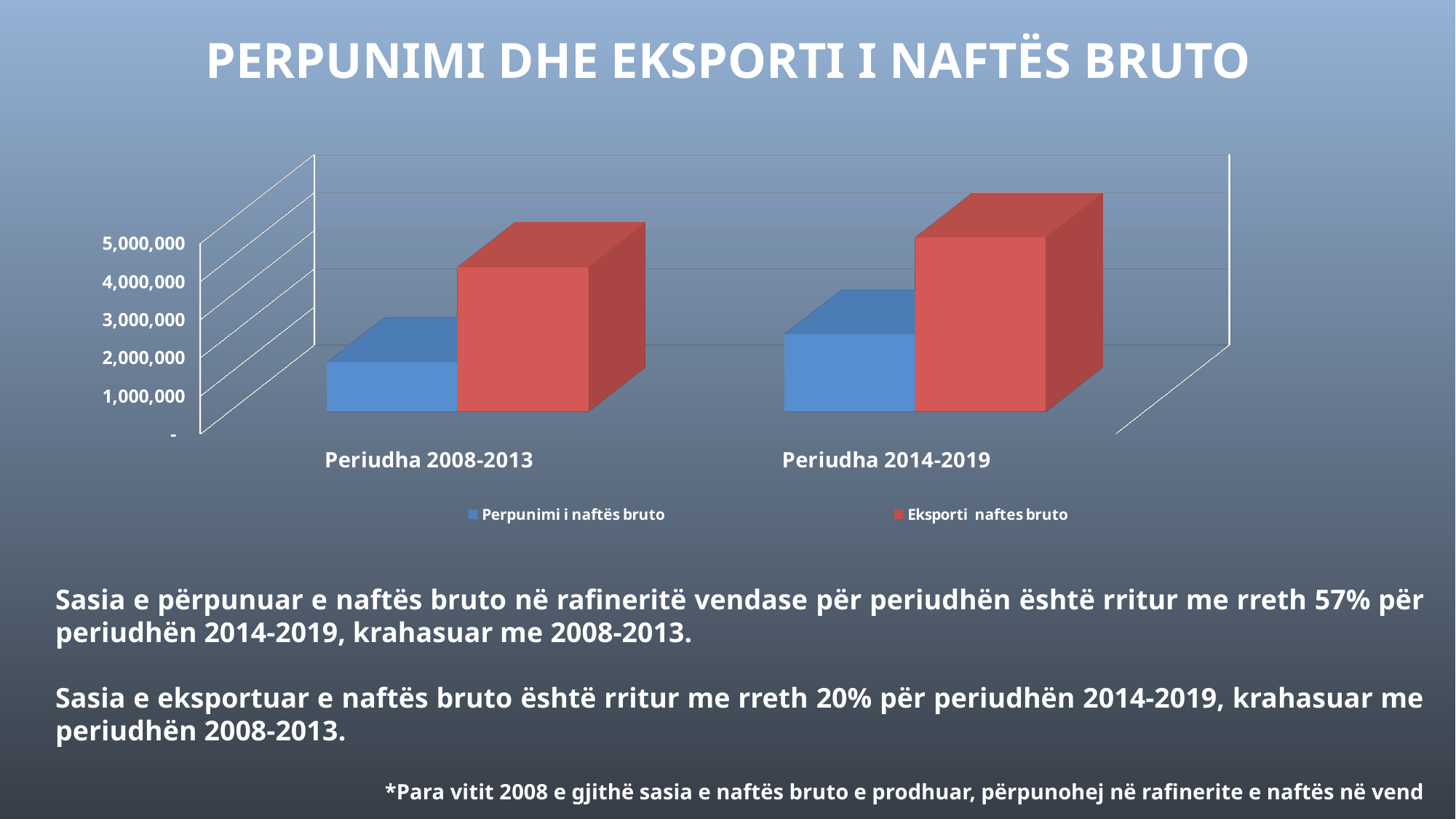
For Periudha 2008-2013, which is larger: Perpunimi i naftës bruto or Eksporti naftes bruto? Eksporti naftes bruto Does Perpunimi i naftës bruto rise or fall from Periudha 2008-2013 to Periudha 2014-2019? rise For Periudha 2014-2019, which is larger: Perpunimi i naftës bruto or Eksporti naftes bruto? Eksporti naftes bruto Is the value of Perpunimi i naftës bruto for Periudha 2008-2013 greater or less than 3,000,000? less How many series does the chart legend list? 2 Which series is shown in red in the chart? Eksporti naftes bruto Is the value of Eksporti naftes bruto for Periudha 2014-2019 greater or less than 3,000,000? greater Which period has the highest value of Eksporti naftes bruto? Periudha 2014-2019 How many periods (categories) are shown on the x axis of the chart? 2 What is the title of the slide containing the chart? PERPUNIMI DHE EKSPORTI I NAFTËS BRUTO What kind of chart is shown on the slide? bar chart Does Eksporti naftes bruto rise or fall from Periudha 2008-2013 to Periudha 2014-2019? rise